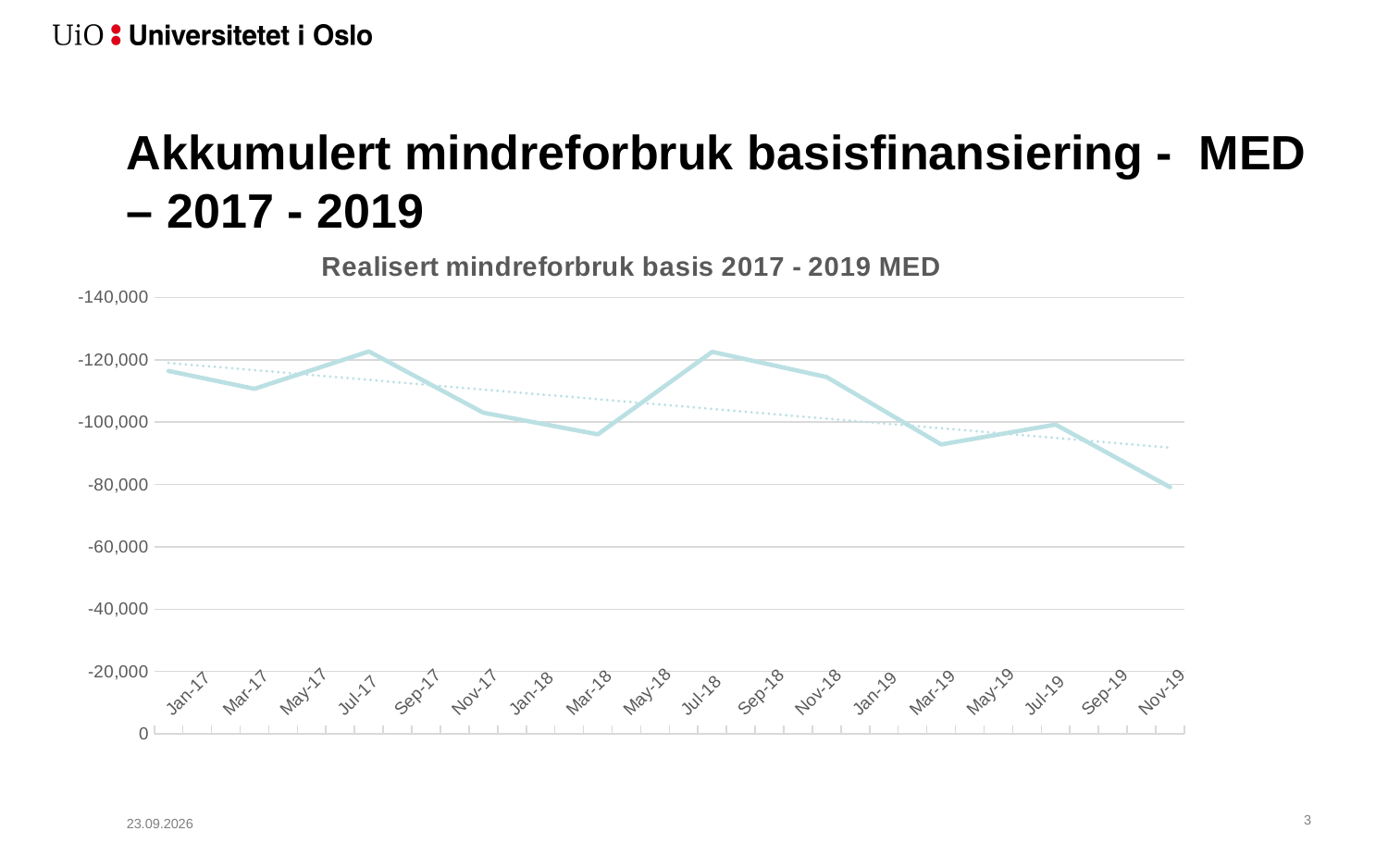
What is the value shown at the top of the y axis? -140,000 What is the title of the chart? Realisert mindreforbruk basis 2017 - 2019 MED Which month has the value closest to zero (the highest value) on the chart? Nov-19 Do the plotted values become more negative or less negative from Jan-17 to Nov-19? less negative Which has the larger (less negative) value, Jul-17 or Nov-19? Nov-19 What kind of chart is shown on the slide? line chart Which has the larger (less negative) value, Jan-17 or Mar-18? Mar-18 How many month labels are shown on the x axis of the chart? 18 Is the value for Nov-19 greater or less than -100,000? greater Is the value for Mar-18 greater or less than -100,000? greater